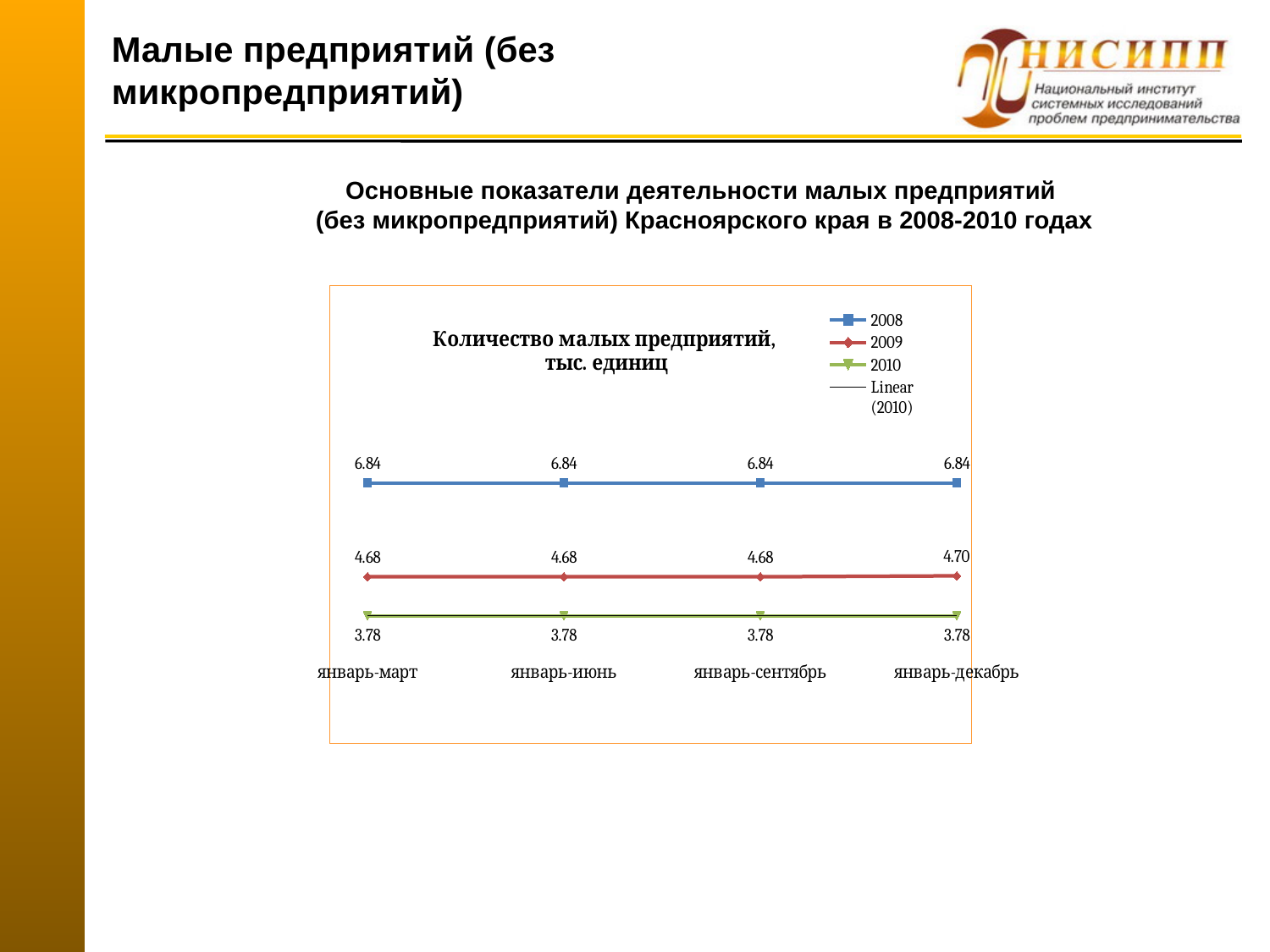
How many periods are shown on the x axis? 4 What is the value for 2009 in январь-июнь? 4.68 What is the value for 2008 in январь-март? 6.84 What type of chart is shown on the slide? line chart What is the difference between the 2008 and 2010 values in январь-март? 3.06 How many entries does the legend list? 4 What is the difference between the 2009 values in январь-декабрь and январь-сентябрь? 0.02 Which series has the highest values across all periods? 2008 Which series has the lowest values across all periods? 2010 What is the value for 2009 in январь-декабрь? 4.70 What is the value for 2010 in январь-сентябрь? 3.78 Which is larger: the 2009 value in январь-март or the 2010 value in январь-март? 2009